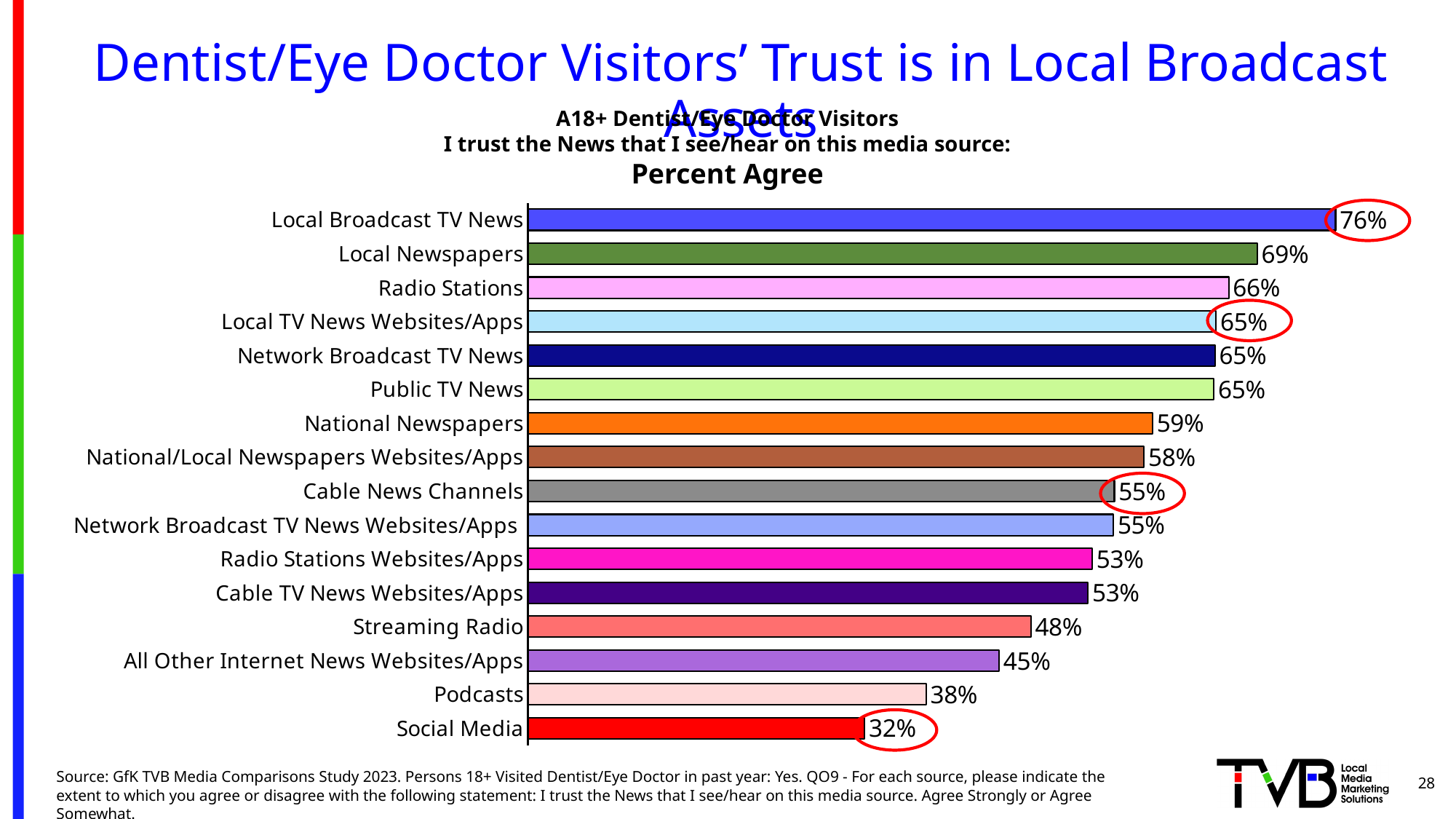
What is the percent agree value for Podcasts? 38% Which has a higher percent agree, Radio Stations or Streaming Radio? Radio Stations Which media source has the lowest percent agree? Social Media How many media sources are shown in the chart? 16 What is the percent agree value for Social Media? 32% What is the difference in percent agree between Local Broadcast TV News and Local Newspapers? 7% What is the percent agree value for Cable News Channels? 55% What is the percent agree value for Local Broadcast TV News? 76% What is the difference in percent agree between Local Broadcast TV News and Social Media? 44% Which media source has the highest percent agree? Local Broadcast TV News What type of chart is shown on the slide? Bar chart What is the value for National Newspapers? 59%